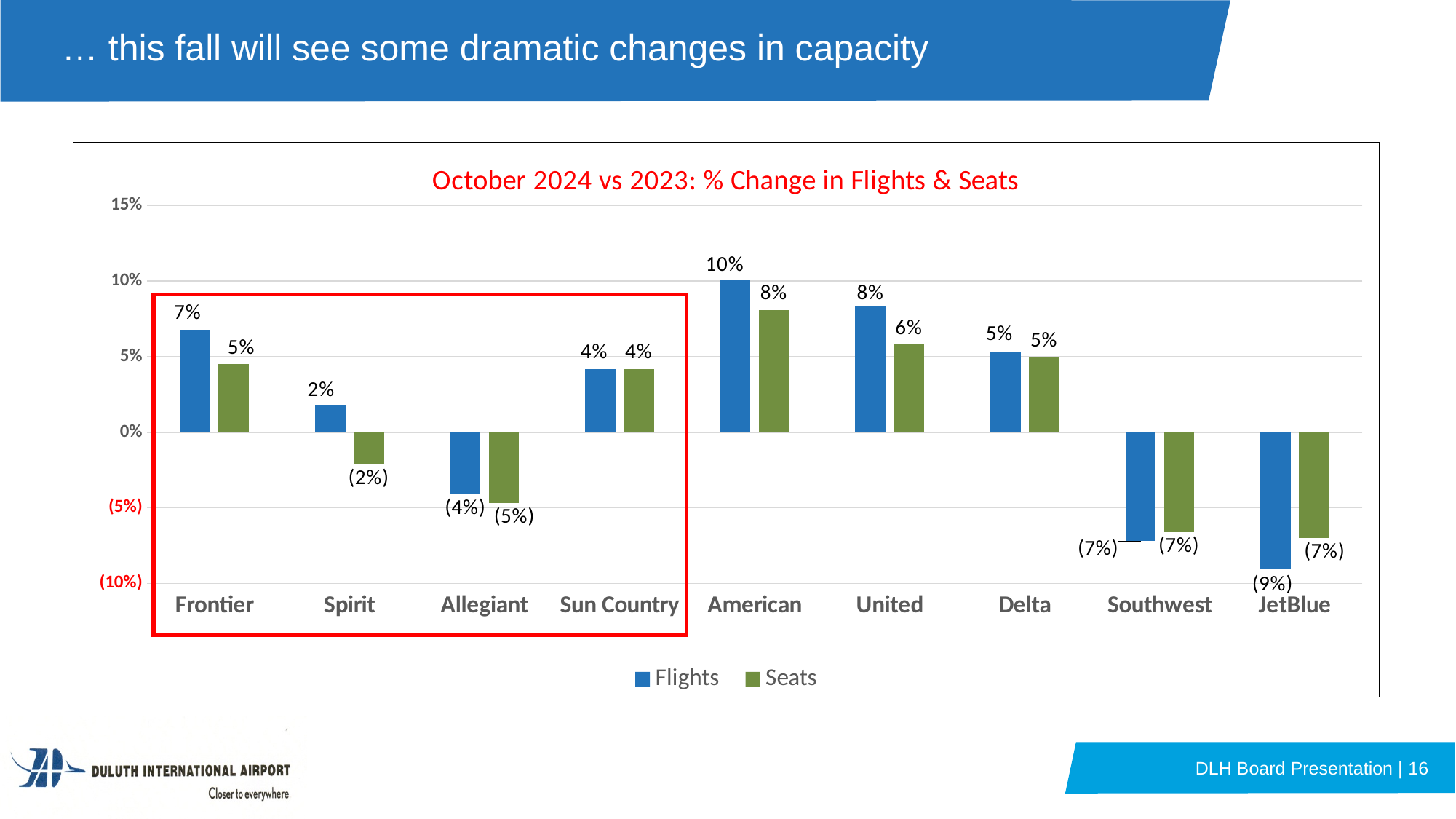
How many airlines are shown on the x axis? 9 What is the % change in Seats for United? 6% Which is larger for Frontier: the % change in Flights or in Seats? Flights What is the difference between the Flights and Seats % change for American? 2 percentage points What kind of chart is shown on the slide? Bar chart How many series does the legend list? 2 What is the % change in Seats for Spirit? (2%) Which airline has the lowest % change in Flights? JetBlue Which airline has the highest % change in Flights? American What is the % change in Flights for American? 10% What is the % change in Flights for JetBlue? (9%) What is the title of the chart? October 2024 vs 2023: % Change in Flights & Seats